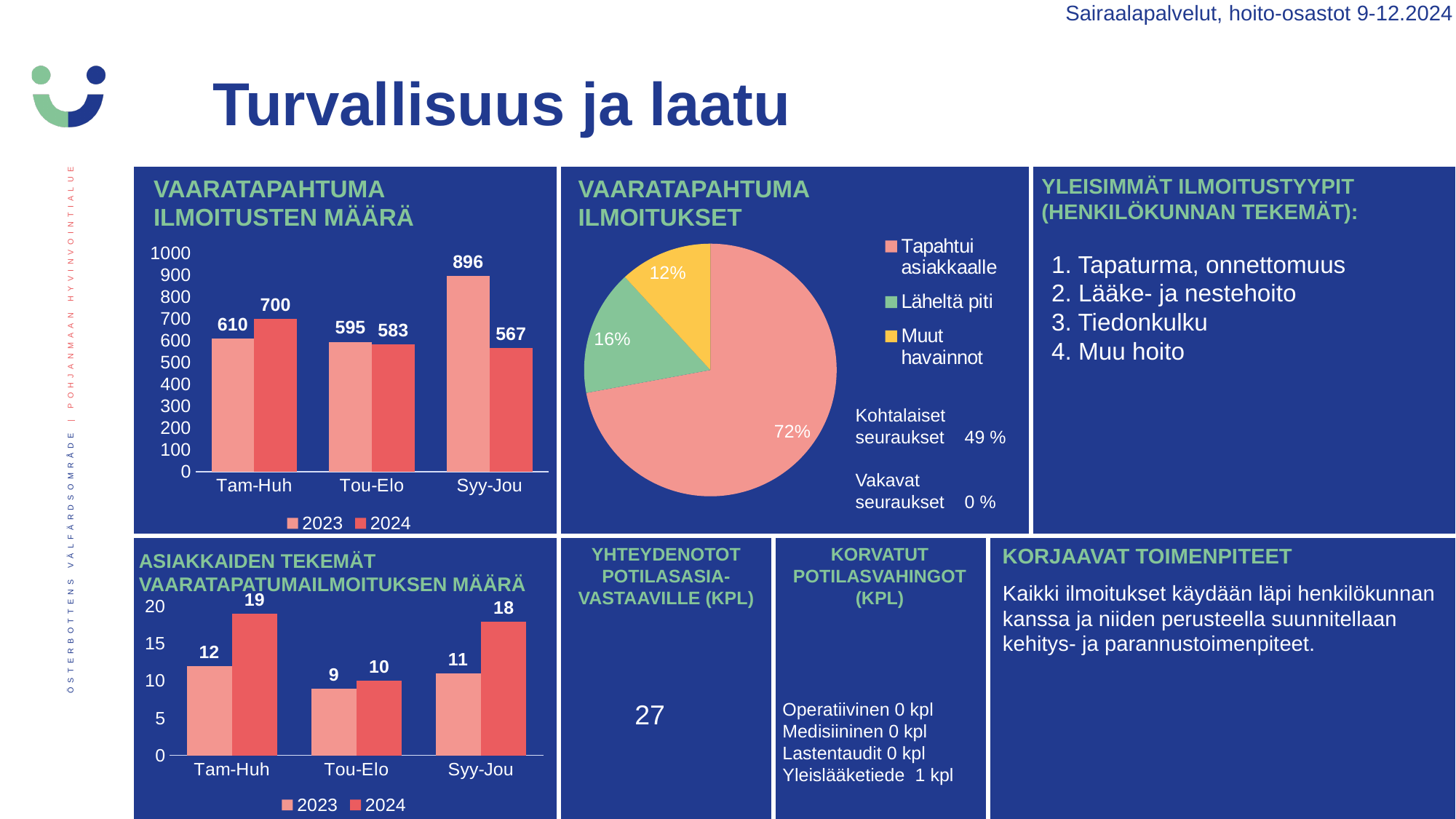
In the 'ASIAKKAIDEN TEKEMÄT VAARATAPATUMAILMOITUKSEN MÄÄRÄ' chart, what is the difference between the 2024 and 2023 values for Syy-Jou? 7 In the 'VAARATAPAHTUMA ILMOITUKSET' pie chart, which category has the largest slice? Tapahtui asiakkaalle In the 'VAARATAPAHTUMA ILMOITUSTEN MÄÄRÄ' chart, what is the 2023 value for Tam-Huh? 610 In the 'ASIAKKAIDEN TEKEMÄT VAARATAPATUMAILMOITUKSEN MÄÄRÄ' chart, what is the 2024 value for Tam-Huh? 19 In the 'VAARATAPAHTUMA ILMOITUSTEN MÄÄRÄ' chart, which is larger for Tou-Elo: the 2023 value or the 2024 value? 2023 In the 'VAARATAPAHTUMA ILMOITUSTEN MÄÄRÄ' chart, what is the difference between the 2023 and 2024 values for Syy-Jou? 329 In the 'ASIAKKAIDEN TEKEMÄT VAARATAPATUMAILMOITUKSEN MÄÄRÄ' chart, which period has the lowest 2023 value? Tou-Elo In the 'VAARATAPAHTUMA ILMOITUSTEN MÄÄRÄ' chart, which period has the highest 2023 value? Syy-Jou What kind of chart is 'VAARATAPAHTUMA ILMOITUKSET'? Pie chart In the 'VAARATAPAHTUMA ILMOITUKSET' pie chart, what share is 'Läheltä piti'? 16% How many series does the legend of the 'VAARATAPAHTUMA ILMOITUSTEN MÄÄRÄ' chart list? 2 In the 'VAARATAPAHTUMA ILMOITUSTEN MÄÄRÄ' chart, what is the 2024 value for Syy-Jou? 567